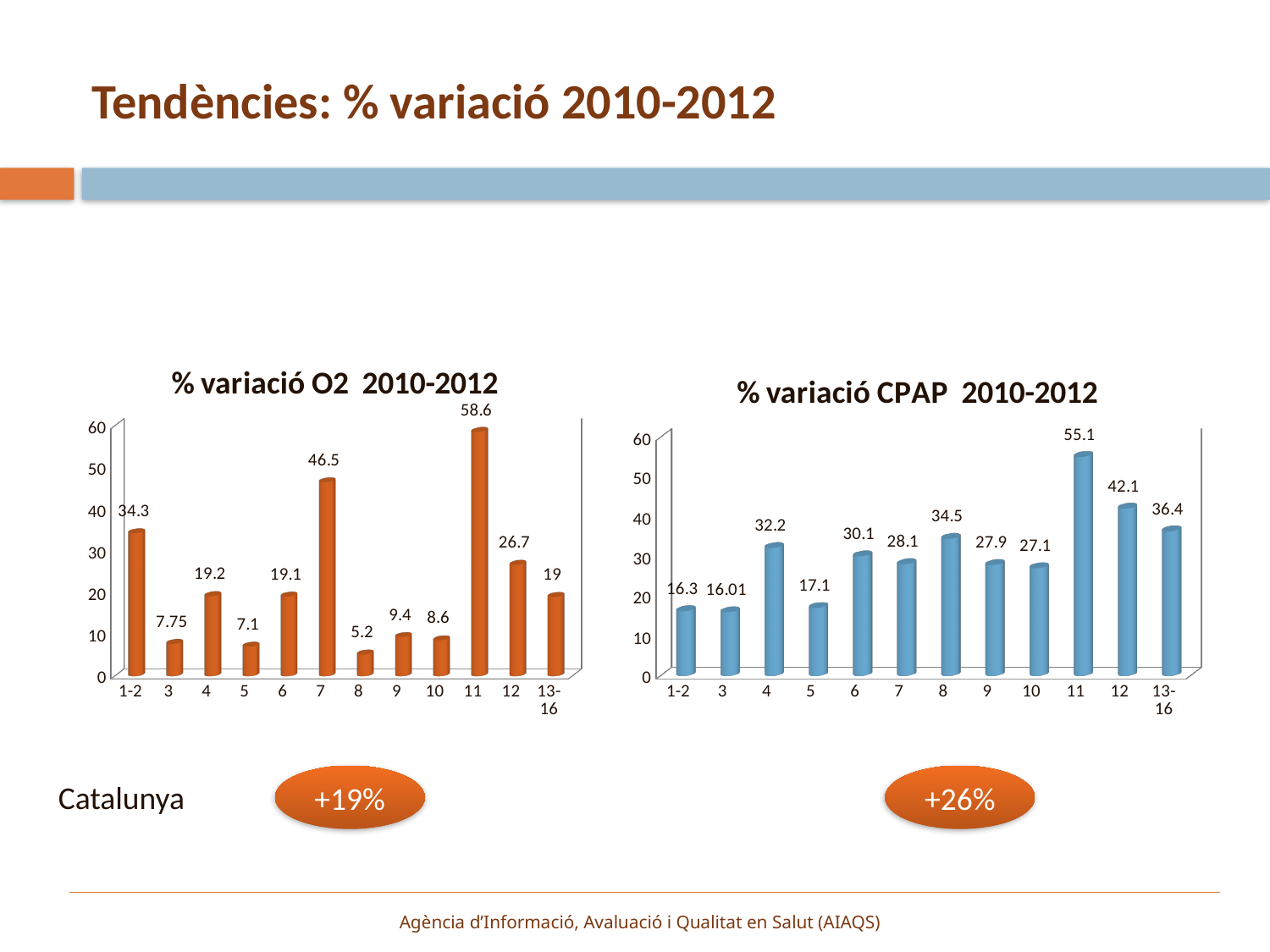
What kind of chart is the '% variació CPAP 2010-2012' chart? bar chart In the '% variació CPAP 2010-2012' chart, is the value for category 8 greater or less than 30? greater In the '% variació CPAP 2010-2012' chart, what is the difference between the values for category 12 and category 13-16? 5.7 In the '% variació O2 2010-2012' chart, what is the value for category 11? 58.6 In the '% variació CPAP 2010-2012' chart, what is the value for category 1-2? 16.3 In the '% variació O2 2010-2012' chart, which category has the lowest value? 8 How many categories are shown on the x axis of the '% variació O2 2010-2012' chart? 12 In the '% variació CPAP 2010-2012' chart, what is the value for category 3? 16.01 In the '% variació O2 2010-2012' chart, what is the difference between the values for category 11 and category 7? 12.1 In the '% variació O2 2010-2012' chart, which is larger: the value for category 4 or category 12? 12 What colour are the bars in the '% variació O2 2010-2012' chart? orange In the '% variació CPAP 2010-2012' chart, which category has the highest value? 11